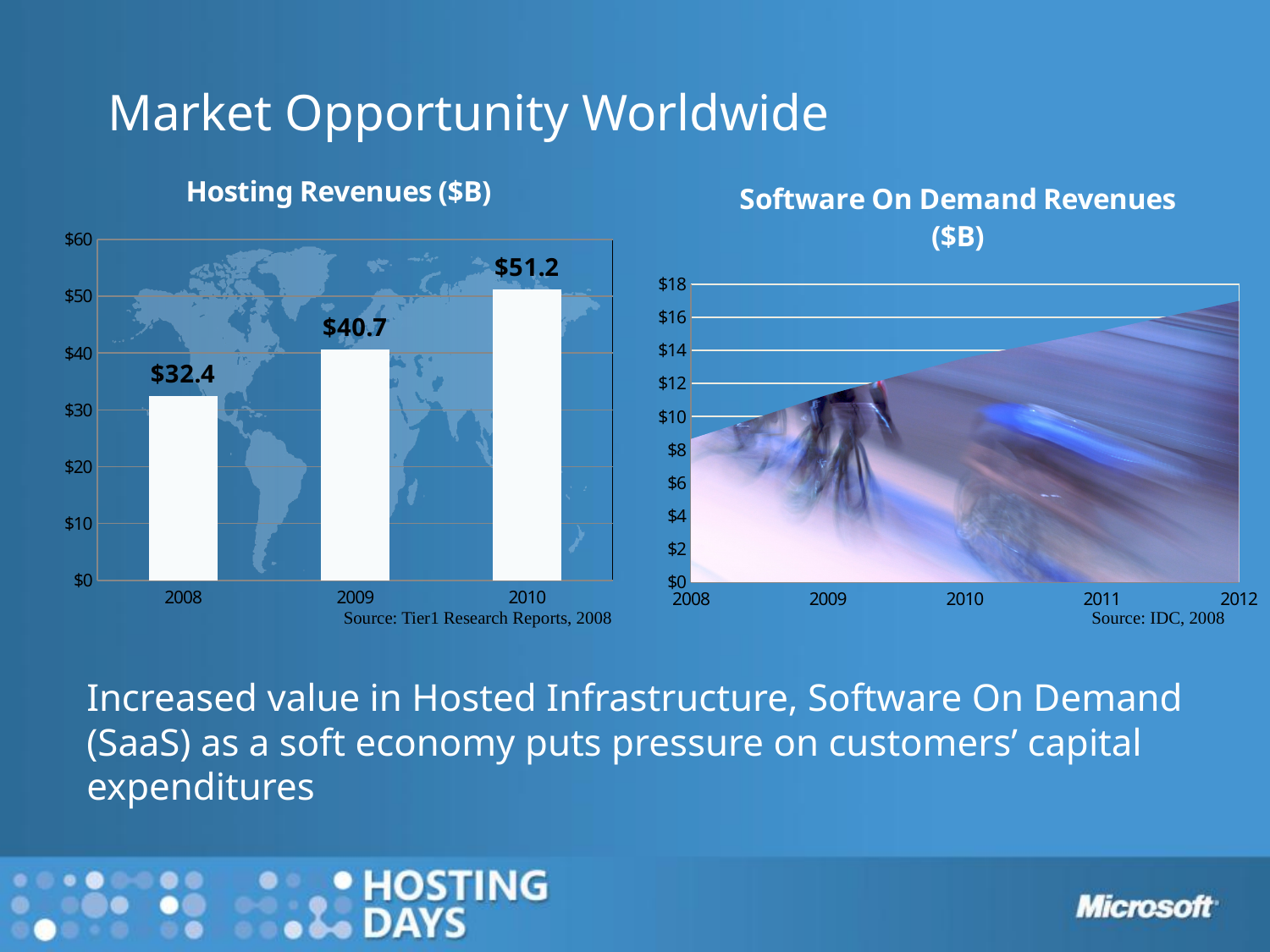
In the Hosting Revenues ($B) chart, what is the difference between the 2010 and 2008 values? $18.8 In the Hosting Revenues ($B) chart, how many years are shown? 3 In the Hosting Revenues ($B) chart, which year has the lowest value? 2008 In the Software On Demand Revenues ($B) chart, is the value for 2012 greater or less than $16? greater In the Hosting Revenues ($B) chart, what is the value for 2008? $32.4 In the Hosting Revenues ($B) chart, which year has the highest value? 2010 In the Hosting Revenues ($B) chart, do the values rise or fall from 2008 to 2010? Rise In the Hosting Revenues ($B) chart, which is larger, the value for 2009 or the value for 2010? 2010 In the Software On Demand Revenues ($B) chart, do the values rise or fall from 2008 to 2012? Rise In the Hosting Revenues ($B) chart, what is the value for 2009? $40.7 What source is cited below the Software On Demand Revenues ($B) chart? Source: IDC, 2008 What kind of chart is the Hosting Revenues ($B) chart? Bar chart